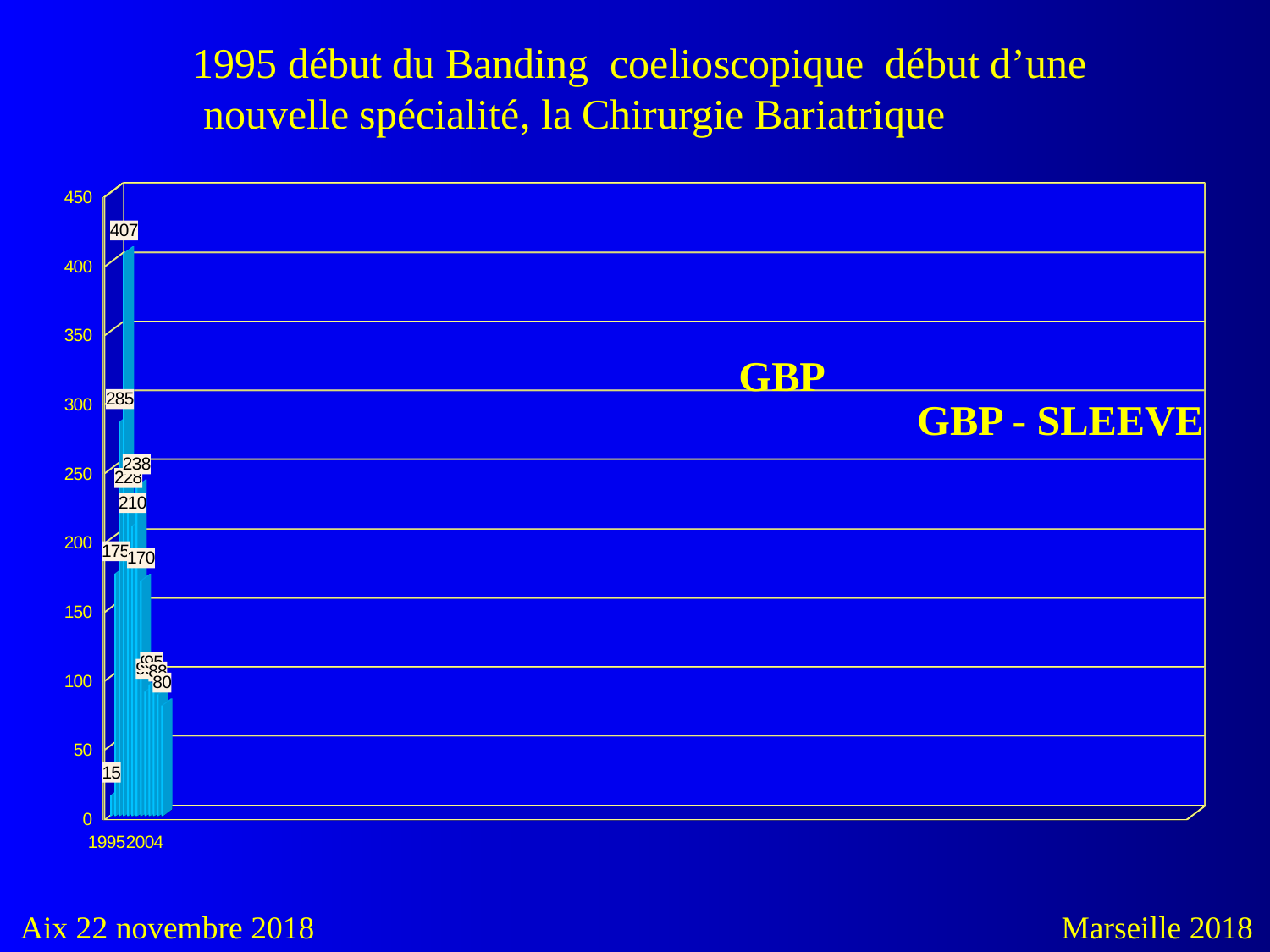
What is the difference between the highest labelled value (407) and the lowest labelled value (15)? 392 What is the highest value labelled on the chart? 407 What is the first year shown on the horizontal axis? 1995 Is the tallest bar greater or less than 400? greater What kind of chart is shown on the slide? bar chart What is the maximum value shown on the vertical axis? 450 Which is larger, the bar labelled 285 or the bar labelled 238? 285 Is the bar labelled 15 greater or less than 50? less What is the lowest value labelled on the chart? 15